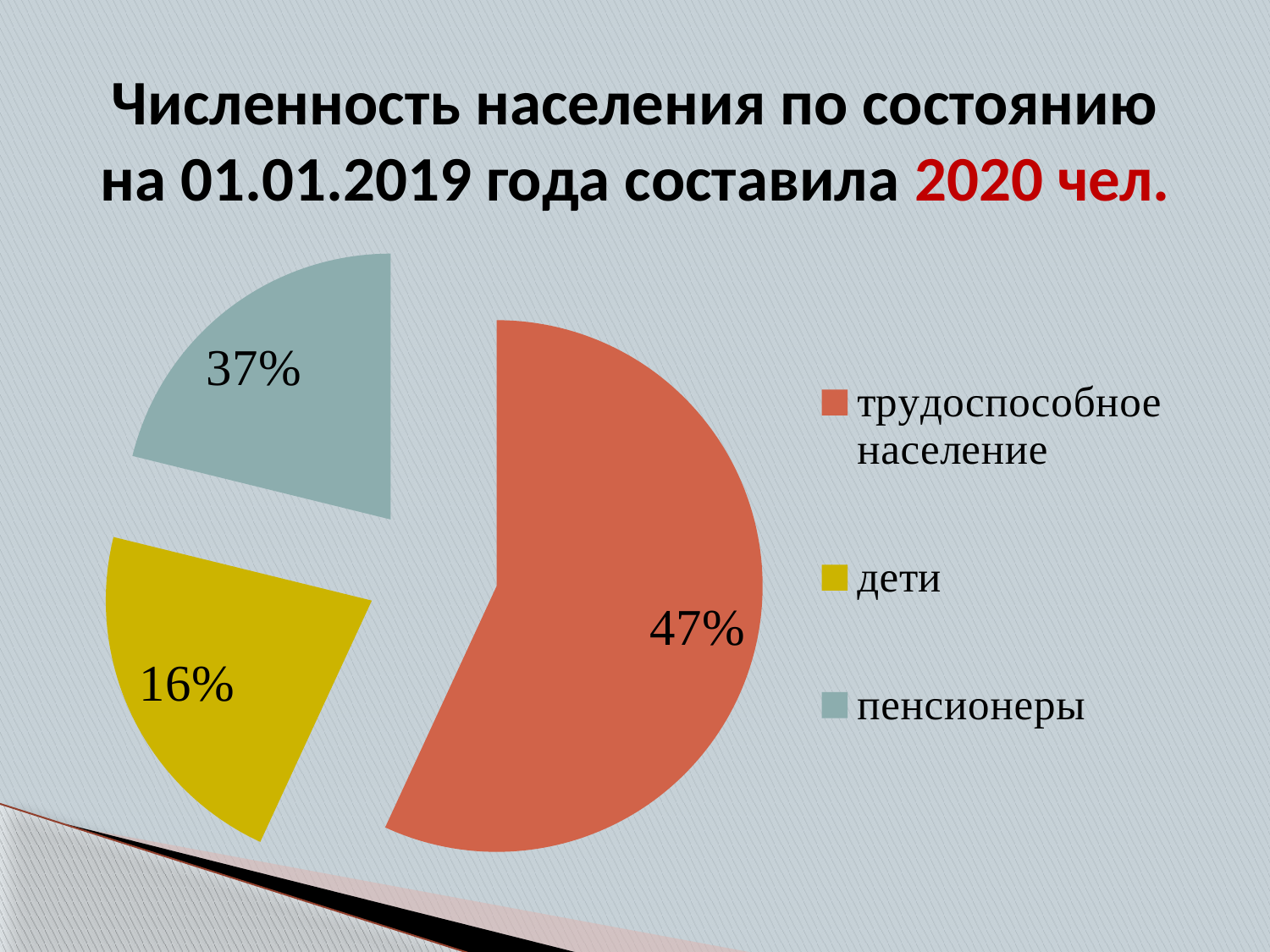
What share of the pie does трудоспособное население have? 47% How many entries does the legend list? 3 Which category has the smallest slice of the pie? дети What is the difference in percentage points between пенсионеры and дети? 21 What share of the pie does дети have? 16% What kind of chart is shown on the slide? pie chart How many slices does the pie chart have? 3 Which is larger, the slice for пенсионеры or the slice for дети? пенсионеры Which category has the largest slice of the pie? трудоспособное население What share of the pie does пенсионеры have? 37% What colour is the slice for дети? yellow What is the difference in percentage points between трудоспособное население and пенсионеры? 10